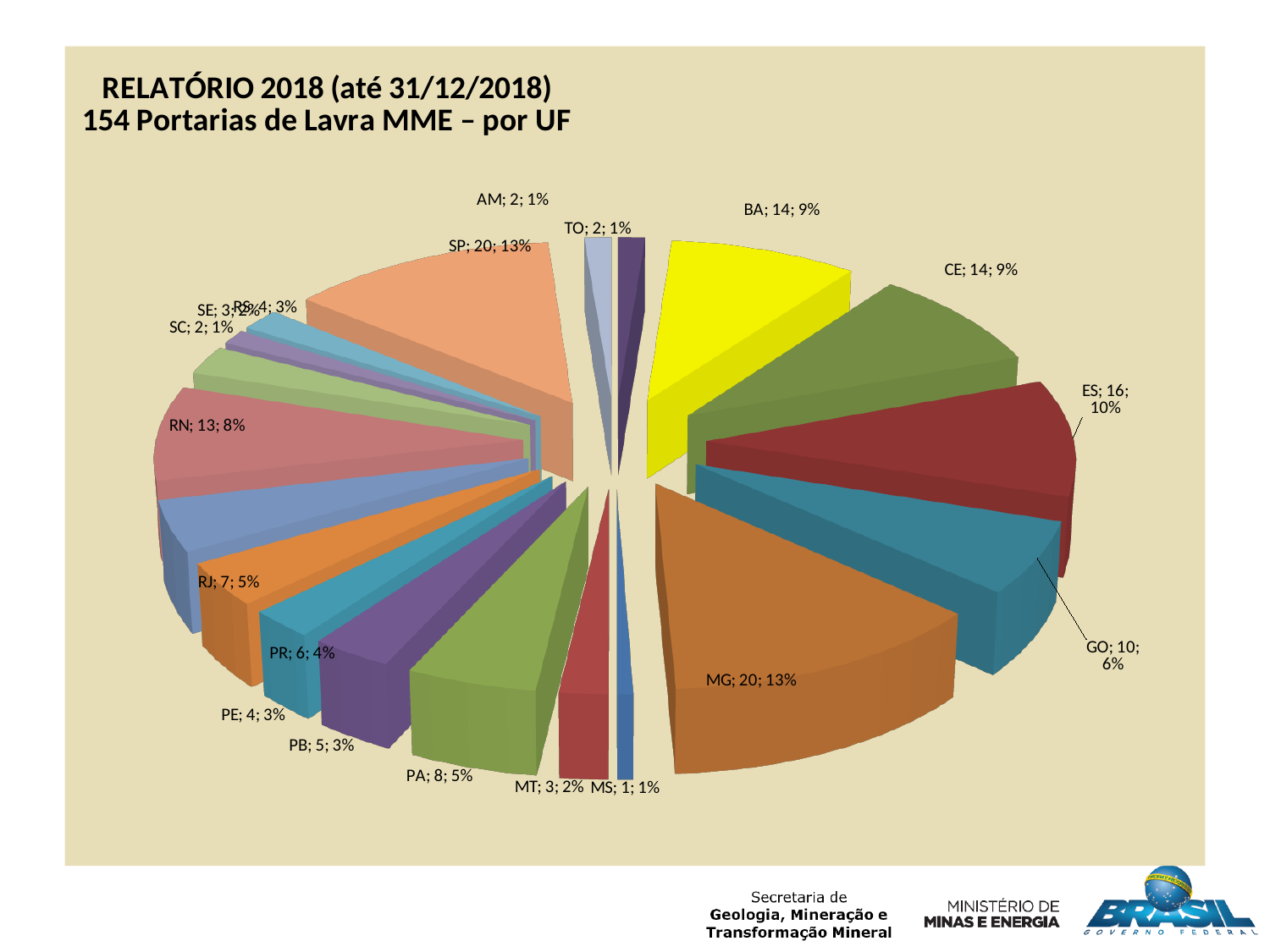
Which two UFs share the largest value in the pie chart? MG and SP What percentage share does the BA slice represent? 9% What percentage share does the MG slice represent? 13% Which has a larger value, BA or RJ? BA What kind of chart is shown on the slide? pie chart What value is shown for GO in the pie chart? 10 What is the total number of Portarias de Lavra stated in the chart title? 154 What is the title of the chart? RELATÓRIO 2018 (até 31/12/2018) 154 Portarias de Lavra MME – por UF What is the difference between the values for MG and BA? 6 Which UF has the smallest slice in the pie chart? MS What value is shown for RN in the pie chart? 13 How many Portarias de Lavra does the chart show for ES? 16